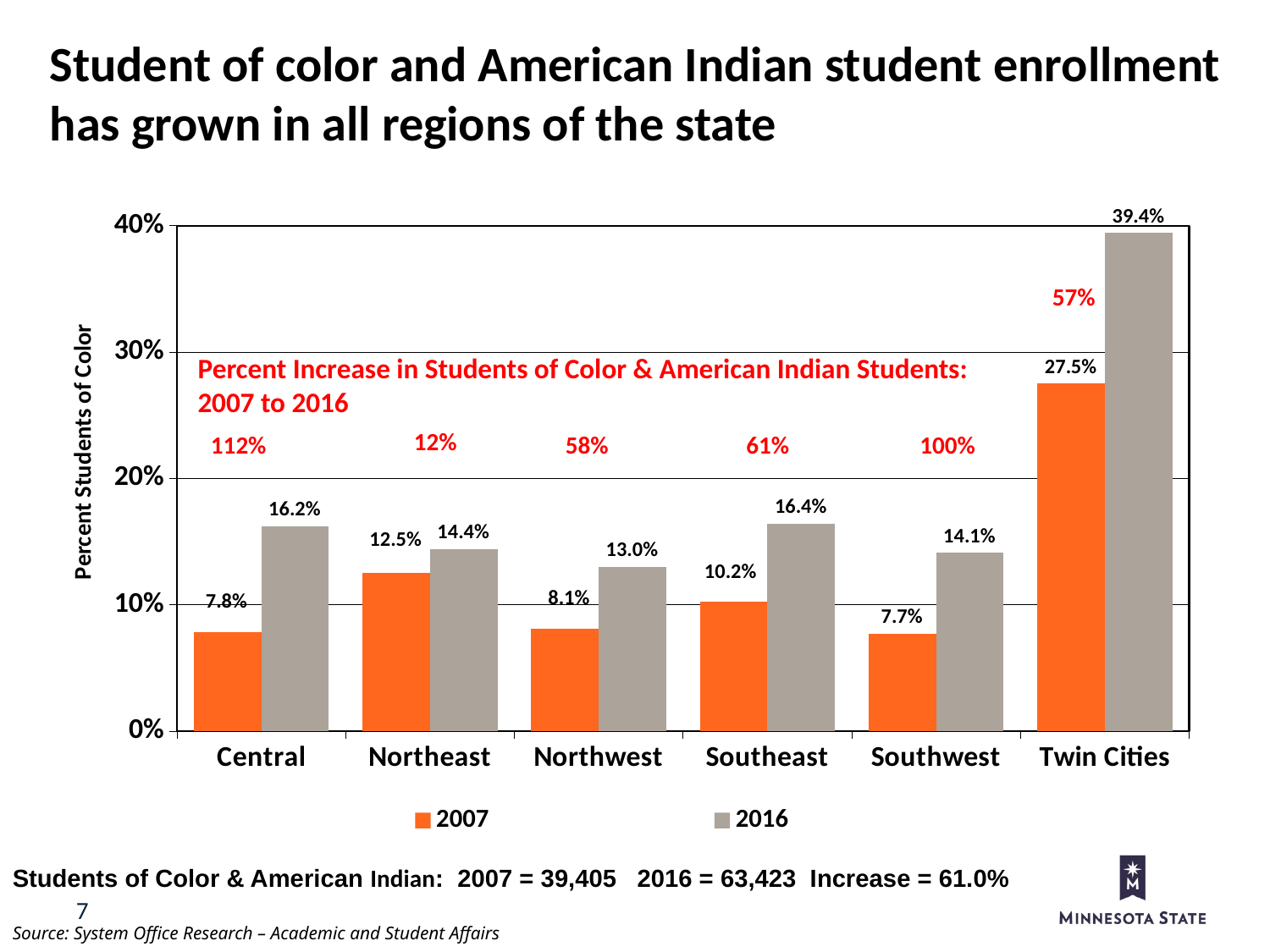
How many regions are shown on the x axis? 6 Which region has the lowest 2016 value? Northwest What kind of chart is shown? Bar chart What is the percent increase shown in red for Central? 112% What is the 2007 value for Central? 7.8% Which region has the highest 2007 value? Twin Cities How many series does the legend list? 2 Which region has the lowest 2007 value? Southwest What is the 2016 value for Twin Cities? 39.4% What is the 2016 value for Southeast? 16.4% What is the difference between the 2016 and 2007 values for Northeast? 1.9% Which is larger, the 2016 value for Central or the 2016 value for Southwest? Central